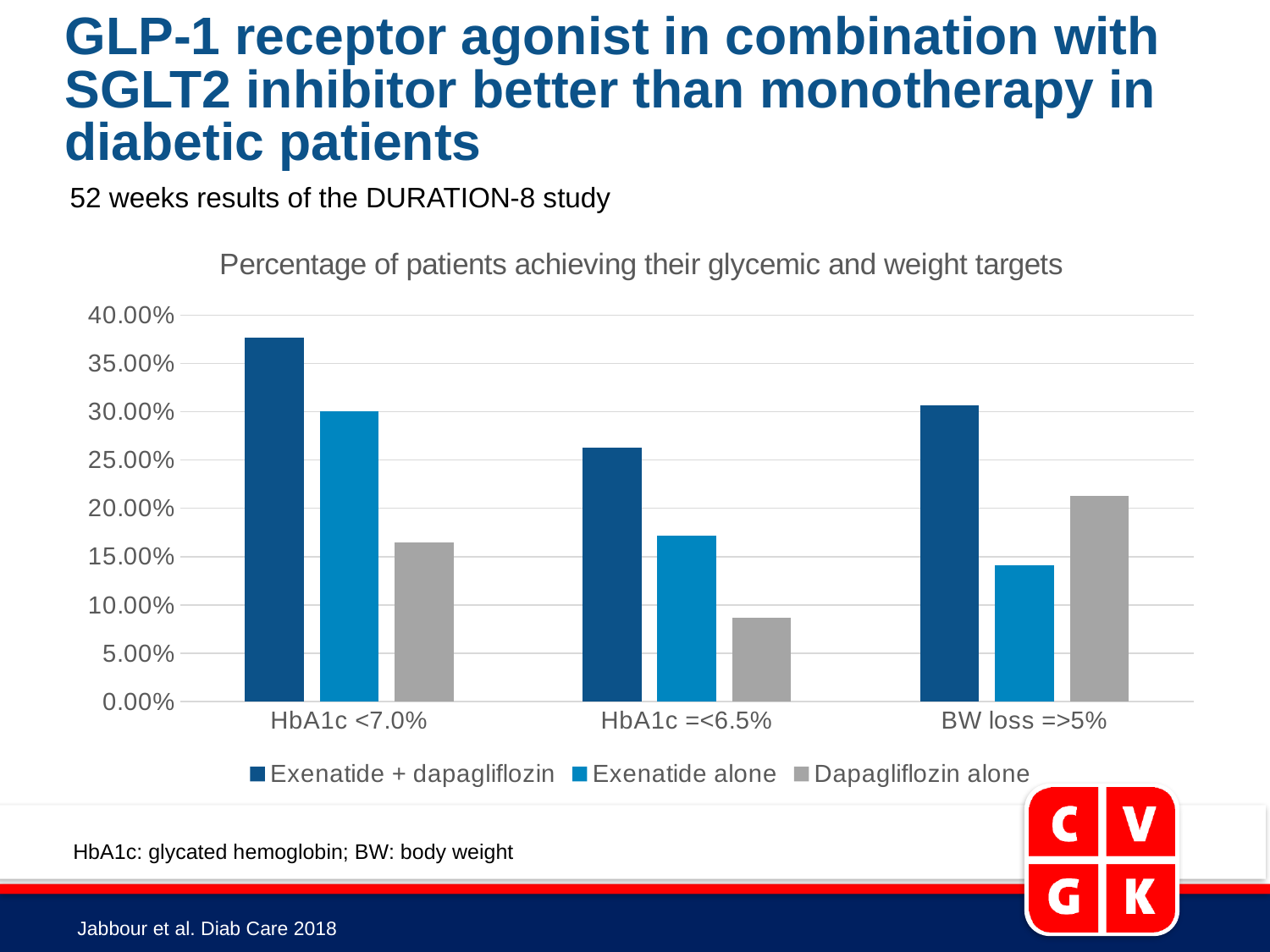
How many series does the legend list? 3 In the BW loss =>5% category, which is larger: Exenatide alone or Dapagliflozin alone? Dapagliflozin alone What kind of chart is shown on the slide? bar chart Is the value for Exenatide + dapagliflozin in the HbA1c <7.0% category greater or less than 35.00%? greater Is the value for Dapagliflozin alone in the HbA1c =<6.5% category greater or less than 10.00%? less Which category has the highest value for the Exenatide alone series? HbA1c <7.0% Which series has the lowest value in the HbA1c =<6.5% category? Dapagliflozin alone Which series has the lowest value in the BW loss =>5% category? Exenatide alone Which series has the highest value in the HbA1c <7.0% category? Exenatide + dapagliflozin What is the title of the chart? Percentage of patients achieving their glycemic and weight targets How many categories are shown on the x axis? 3 Is the value for Exenatide alone in the BW loss =>5% category greater or less than 15.00%? less